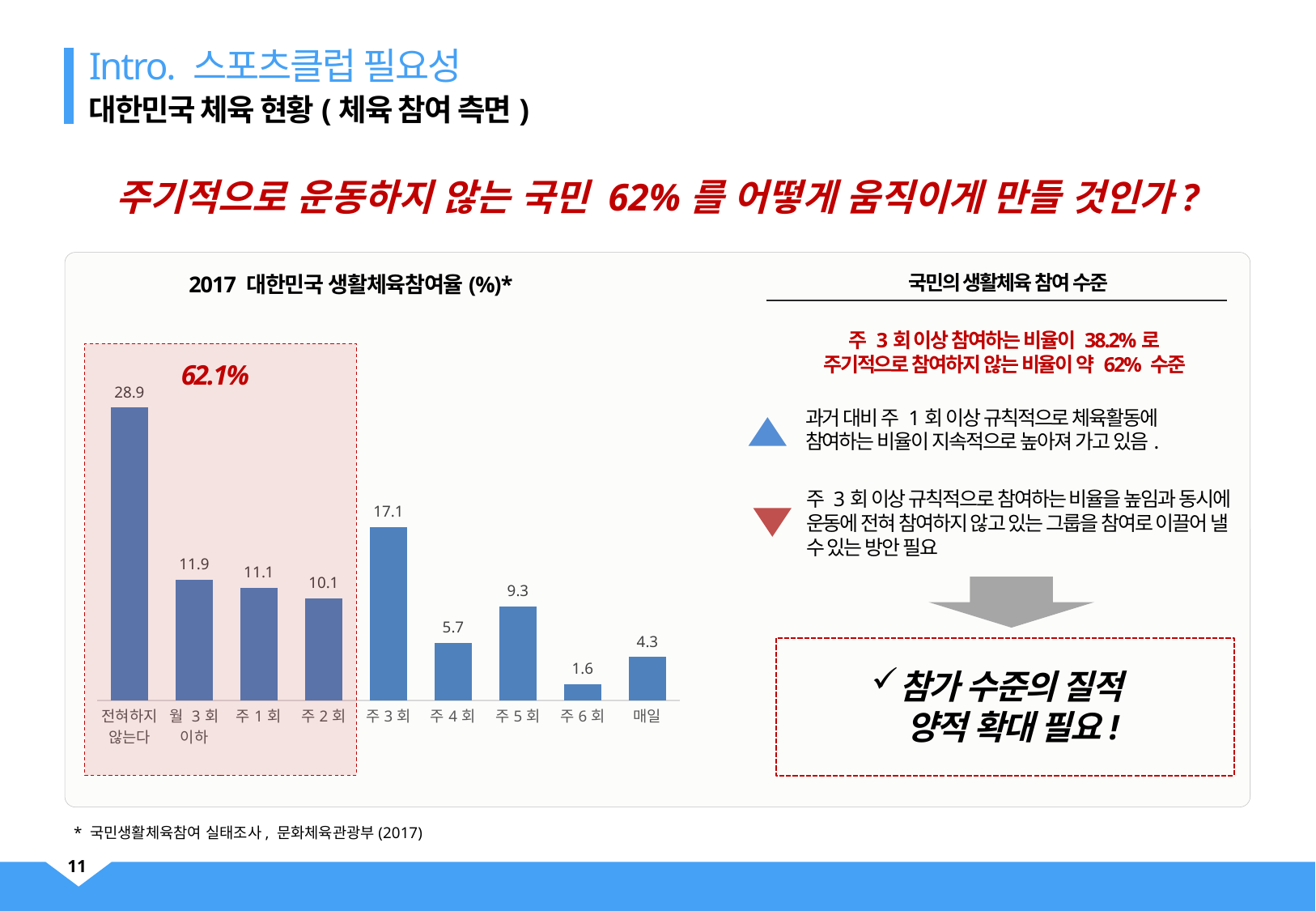
What is the value for 주 3회 in the chart? 17.1 What is the value for 주 6회 in the chart? 1.6 What kind of chart is shown on the slide? Bar chart What is the title of the chart? 2017 대한민국 생활체육참여율 (%)* How many categories are shown in the chart? 9 What is the total of the values for 주 1회 and 주 2회? 21.2 What is the difference between the values for 전혀하지 않는다 and 주 3회? 11.8 Which category has the lowest value in the chart? 주 6회 Which is larger, the value for 주 5회 or the value for 주 4회? 주 5회 Which category has the highest value in the chart? 전혀하지 않는다 What is the value for 매일 in the chart? 4.3 What is the value for 전혀하지 않는다 in the chart? 28.9